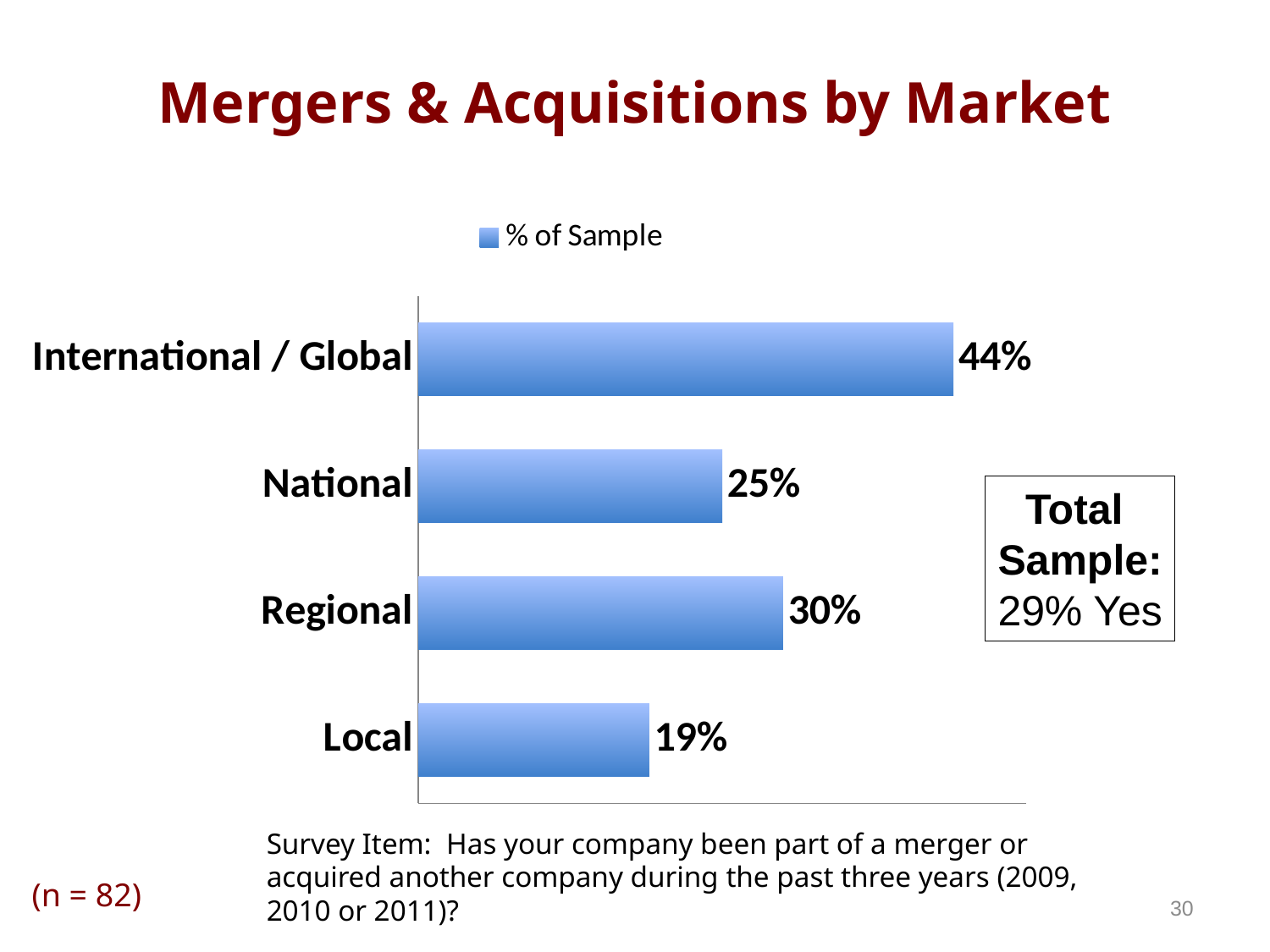
What is the value for National? 25% What is the value for Regional? 30% Which market has the lowest value? Local What is the difference between the values for Regional and National? 5% What is the value for International / Global? 44% How many market categories are shown in the chart? 4 What is the difference between the values for International / Global and Local? 25% What series name does the legend show? % of Sample What is the value for Local? 19% What kind of chart is shown on the slide? Bar chart Which is larger, the value for Regional or the value for National? Regional Which market has the highest value? International / Global